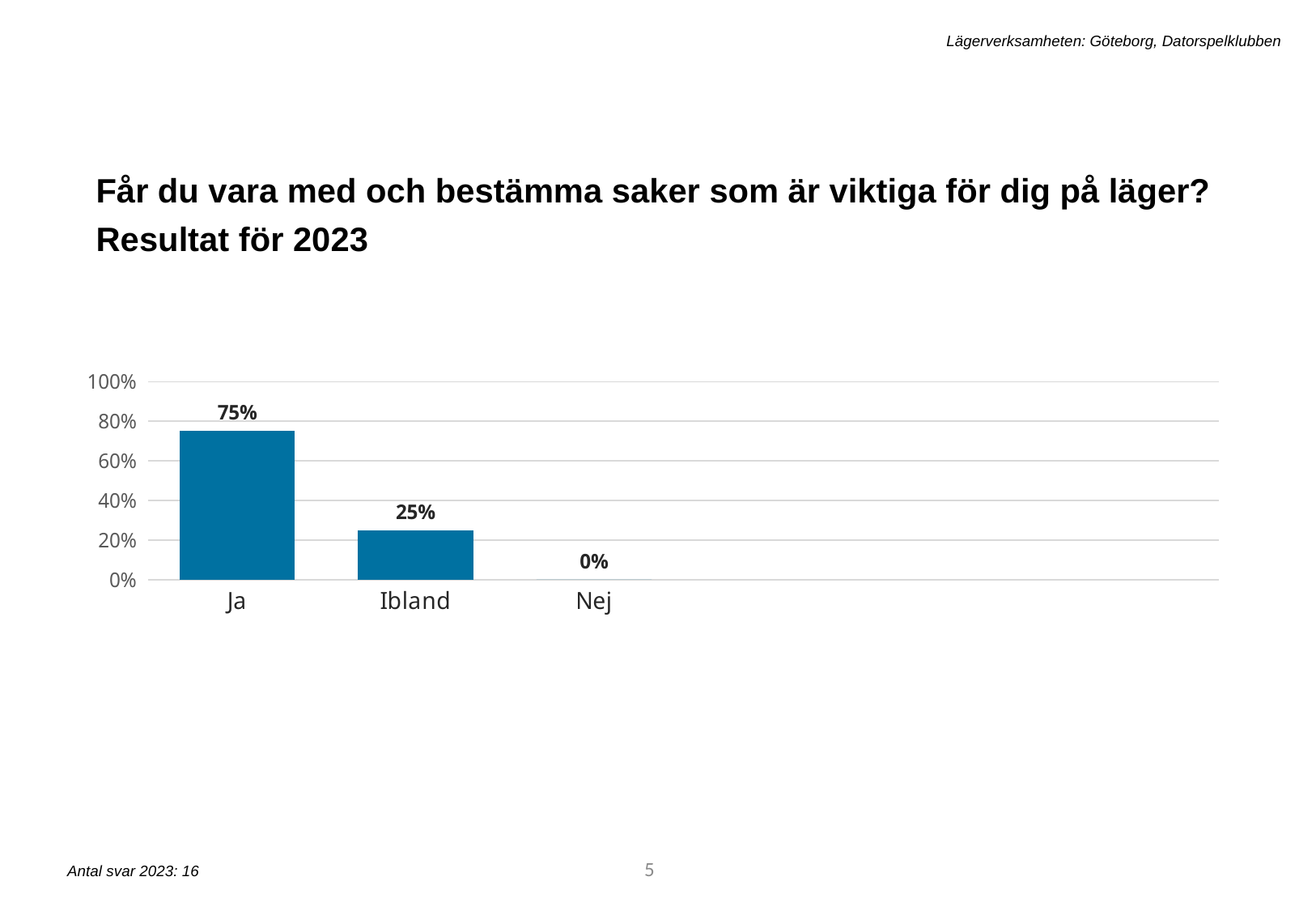
What is the value for Nej? 0% Which is larger, the value for Ibland or the value for Nej? Ibland Which category has the highest value? Ja Do the values rise or fall from Ja to Nej along the x axis? fall What is the value for Ibland? 25% What kind of chart is shown on the slide? bar chart How many categories are shown on the x axis? 3 What is the value for Ja? 75% What is the highest tick value shown on the y axis? 100% Which category has the lowest value? Nej Is the value for Ja greater or less than 60%? greater What is the difference between the values for Ja and Ibland? 50%